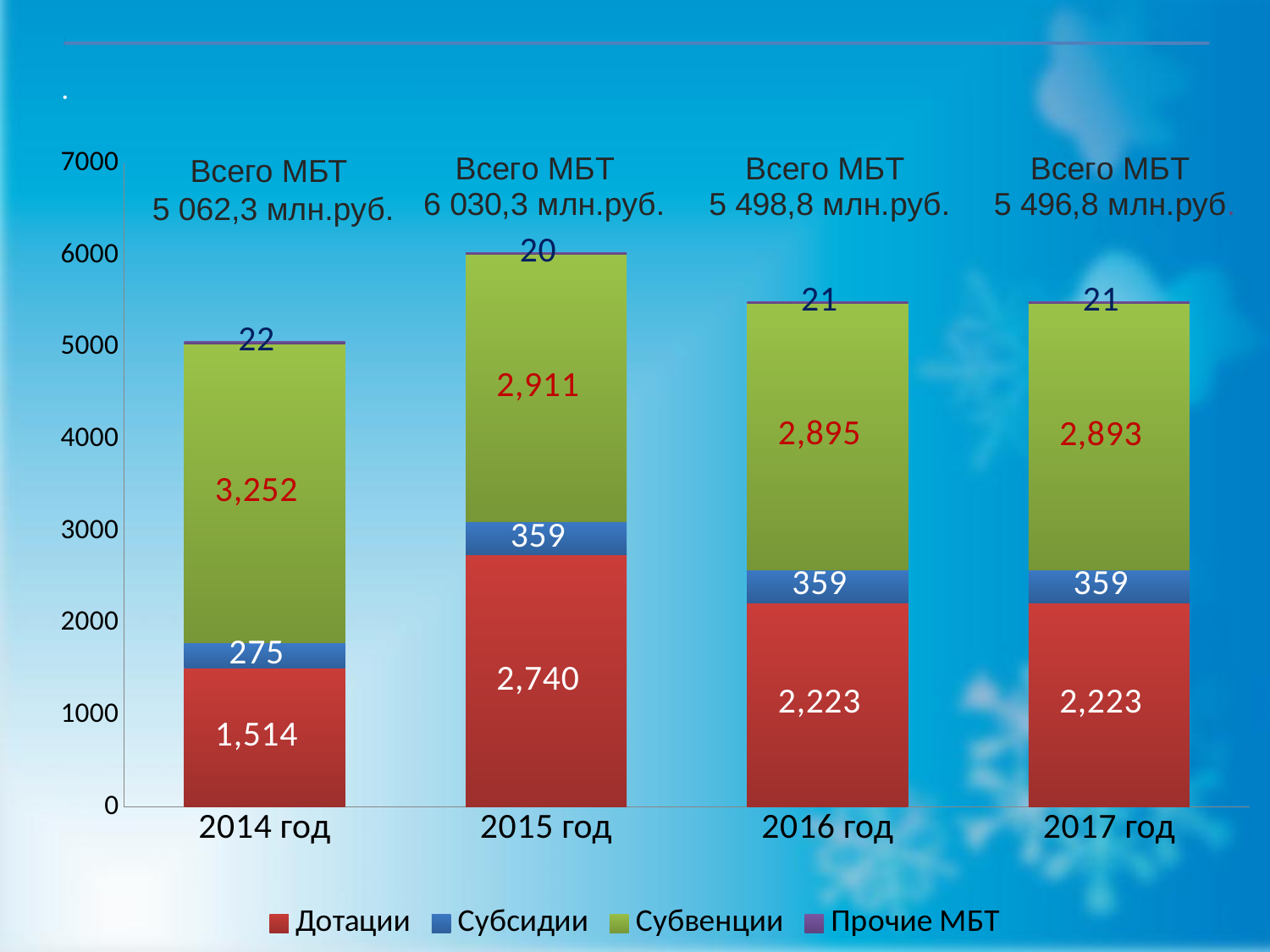
What is the value of Дотации for 2014 год? 1,514 What is the difference between the Дотации values for 2015 год and 2014 год? 1,226 In which year is the Дотации value highest? 2015 год What is the value of Прочие МБТ for 2016 год? 21 What total (Всего МБТ) is printed above the 2015 год bar? 6 030,3 млн.руб. How many years (categories) are shown on the x axis? 4 How many series does the legend list? 4 What type of chart is shown on the slide? stacked bar chart What is the value of Субвенции for 2015 год? 2,911 What is the value of Субсидии for 2014 год? 275 In which year is the Субвенции value lowest? 2017 год Which is larger: Субвенции in 2014 год or Субвенции in 2016 год? Субвенции in 2014 год